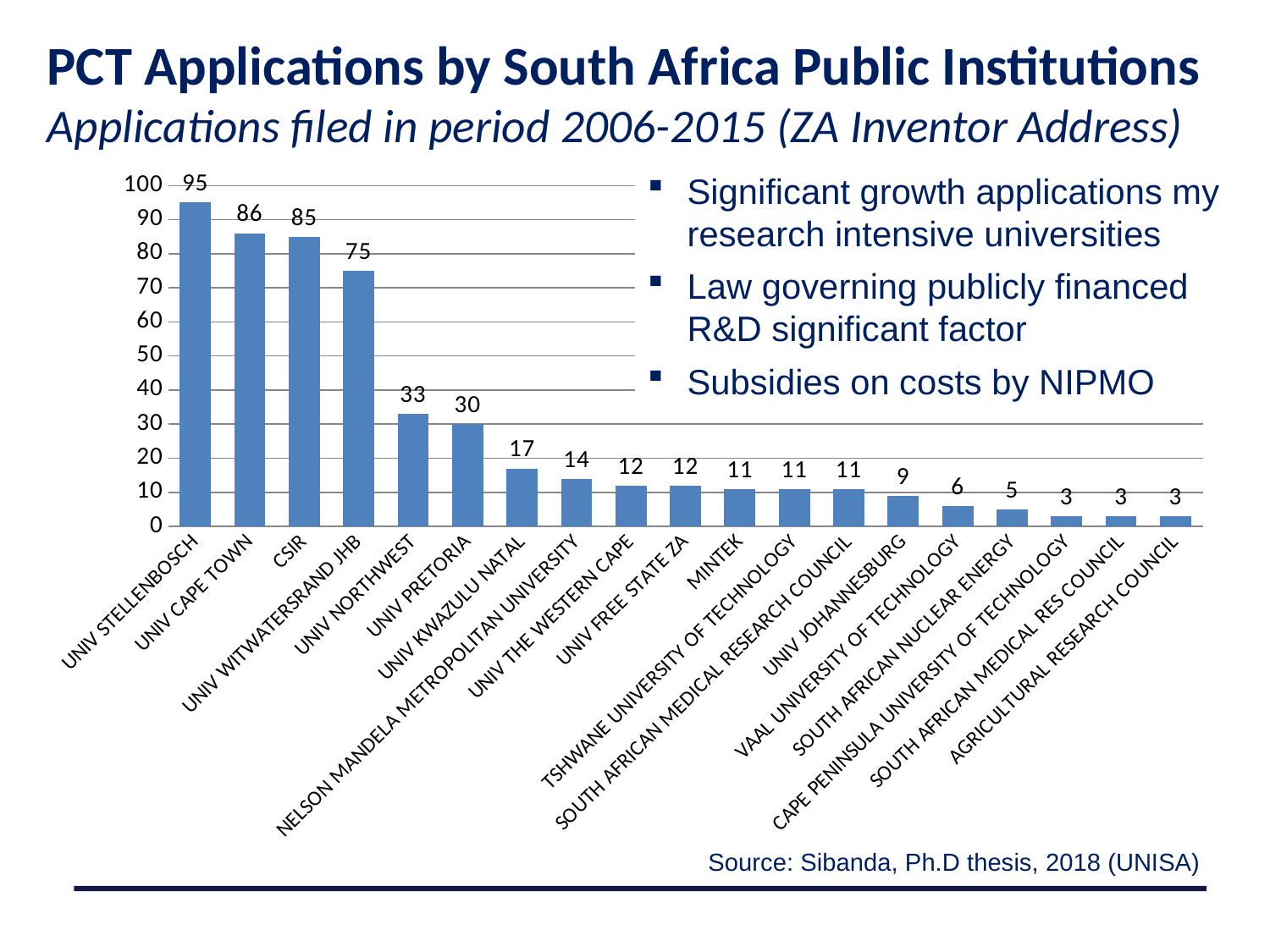
What kind of chart is shown on the slide? Bar chart Is the value for UNIV WITWATERSRAND JHB greater or less than 70? greater Which institution has the highest number of PCT applications? UNIV STELLENBOSCH How many PCT applications are shown for UNIV STELLENBOSCH? 95 What is the difference between the values for UNIV CAPE TOWN and UNIV WITWATERSRAND JHB? 11 What is the lowest value shown on the chart? 3 Do the values rise or fall from left to right along the x axis? Fall How many institutions are shown on the chart? 19 What is the value for UNIV JOHANNESBURG? 9 Which has a larger value, UNIV NORTHWEST or UNIV KWAZULU NATAL? UNIV NORTHWEST What is the value for UNIV PRETORIA? 30 What is the value for CSIR? 85